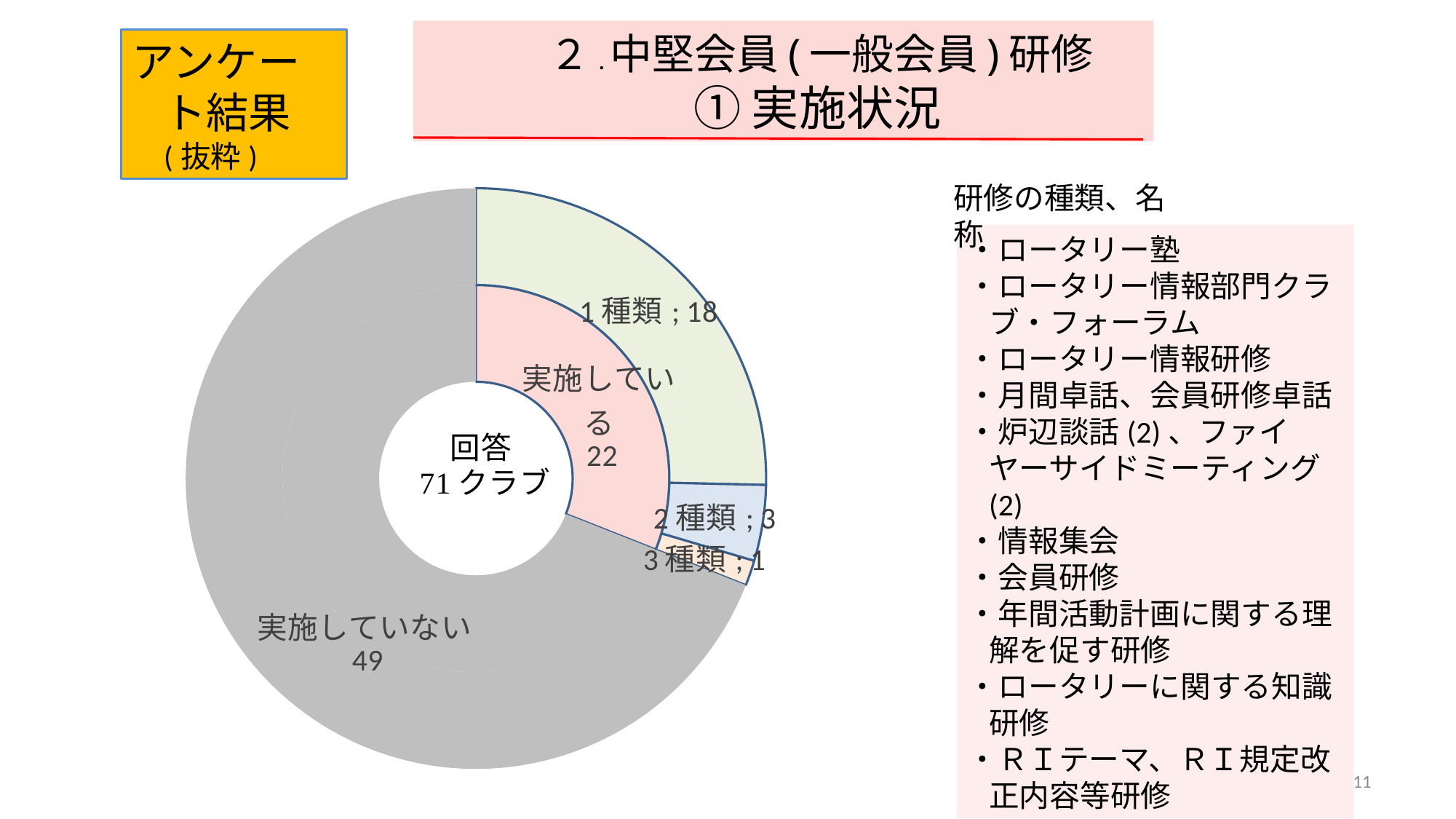
What is the value for 2種類 in the outer ring? 3 What is the difference between 実施していない (49) and 実施している (22)? 27 What is the value for 1種類 in the outer ring? 18 How many clubs answered 実施している in the inner ring? 22 What is the total of 実施している and 実施していない? 71 What is the value for 3種類 in the outer ring? 1 Which of the labeled outer-ring categories (1種類, 2種類, 3種類) has the highest value? 1種類 Which inner-ring category has the larger value, 実施している or 実施していない? 実施していない What kind of chart is shown on the slide? Doughnut chart What text is shown in the centre of the doughnut chart? 回答 71クラブ How many clubs answered 実施していない in the inner ring? 49 Which of the labeled outer-ring categories (1種類, 2種類, 3種類) has the lowest value? 3種類